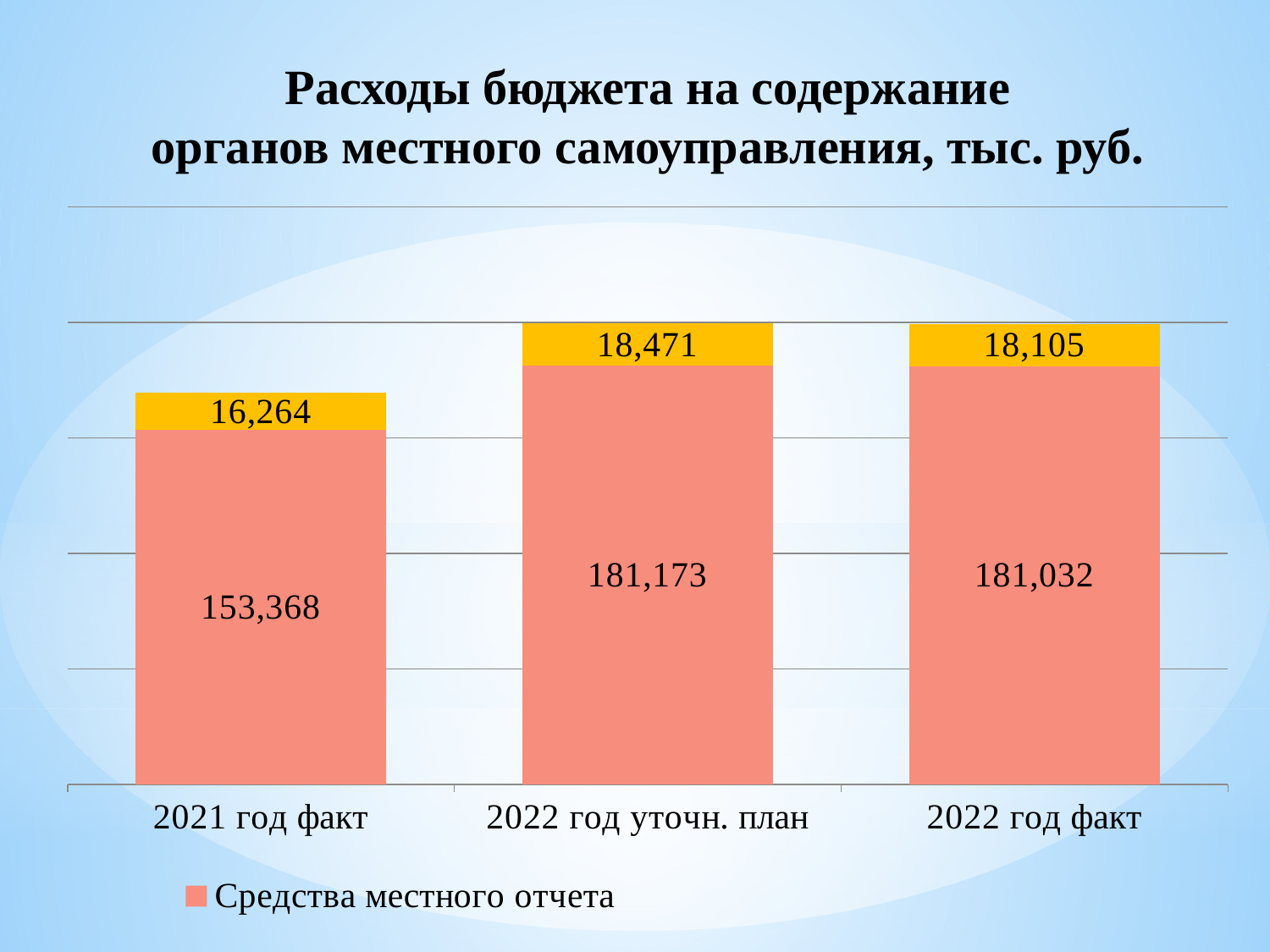
What is the value of the yellow (top) segment for 2022 год уточн. план? 18,471 How many categories are shown on the x axis? 3 What is the value of the Средства местного отчета series for 2022 год уточн. план? 181,173 What is the value of the Средства местного отчета series for 2022 год факт? 181,032 What is the value of the yellow (top) segment for 2021 год факт? 16,264 Which category has the lowest value for the Средства местного отчета series? 2021 год факт Which category has the highest value for the Средства местного отчета series? 2022 год уточн. план What kind of chart is shown on the slide? Stacked bar chart What is the difference between the Средства местного отчета values for 2022 год уточн. план and 2021 год факт? 27,805 What is the value of the Средства местного отчета series for 2021 год факт? 153,368 Which is larger: the yellow segment for 2022 год уточн. план or for 2022 год факт? 2022 год уточн. план What is the total of the stacked bar for 2021 год факт? 169,632